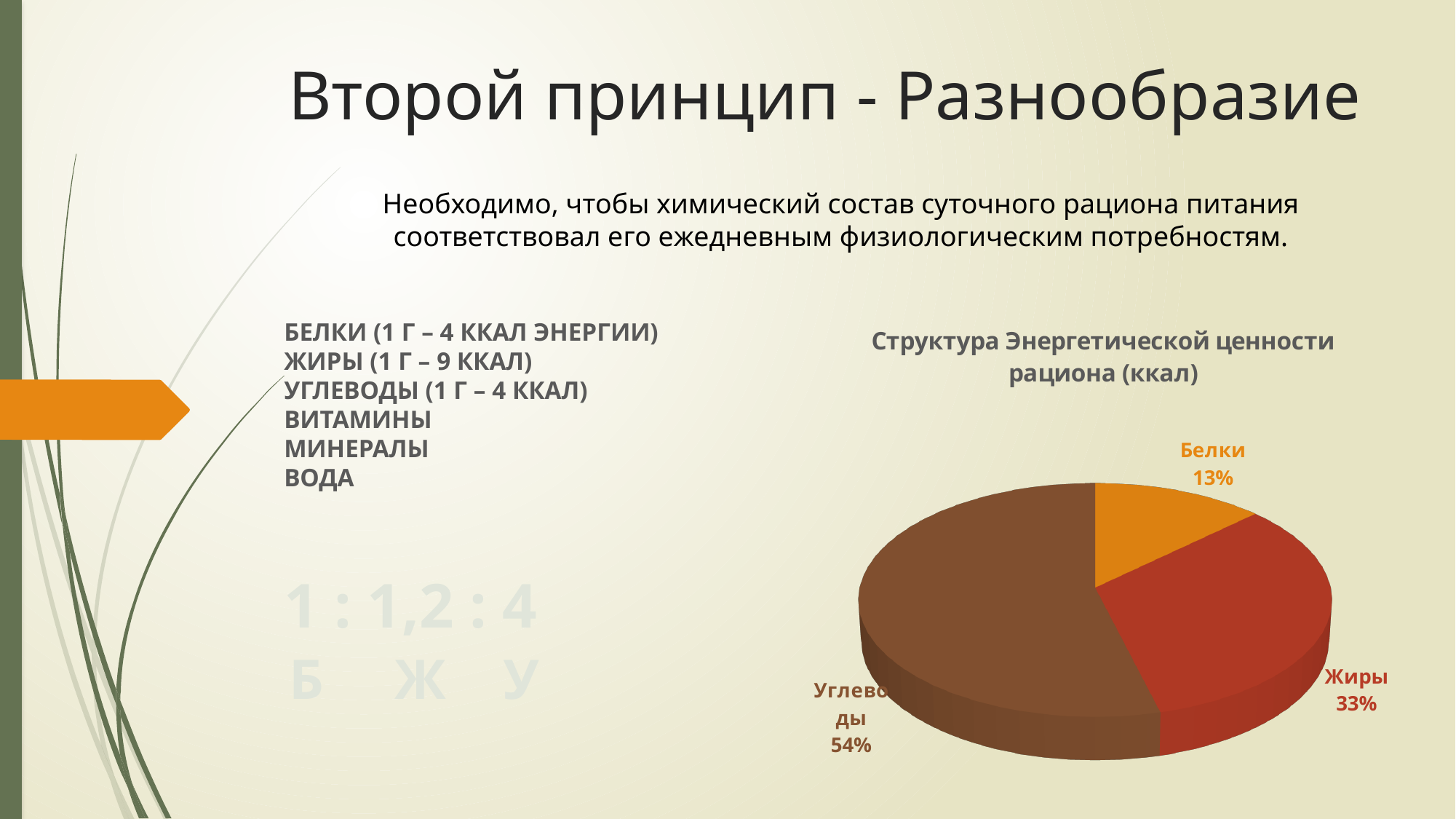
What kind of chart is shown on the slide? Pie chart How many slices does the pie chart have? 3 What is the value shown for Белки in the pie chart? 13% What is the value shown for Жиры in the pie chart? 33% What is the title of the chart on the slide? Структура Энергетической ценности рациона (ккал) What colour is the Белки slice in the pie chart? Orange By how many percentage points does Углеводы exceed Жиры in the pie chart? 21 What share of the pie does Углеводы take in the chart 'Структура Энергетической ценности рациона (ккал)'? 54% By how many percentage points does Углеводы exceed Белки in the pie chart? 41 Which category has the largest slice in the pie chart? Углеводы Which is larger in the pie chart, Жиры or Белки? Жиры Which category has the smallest slice in the pie chart? Белки